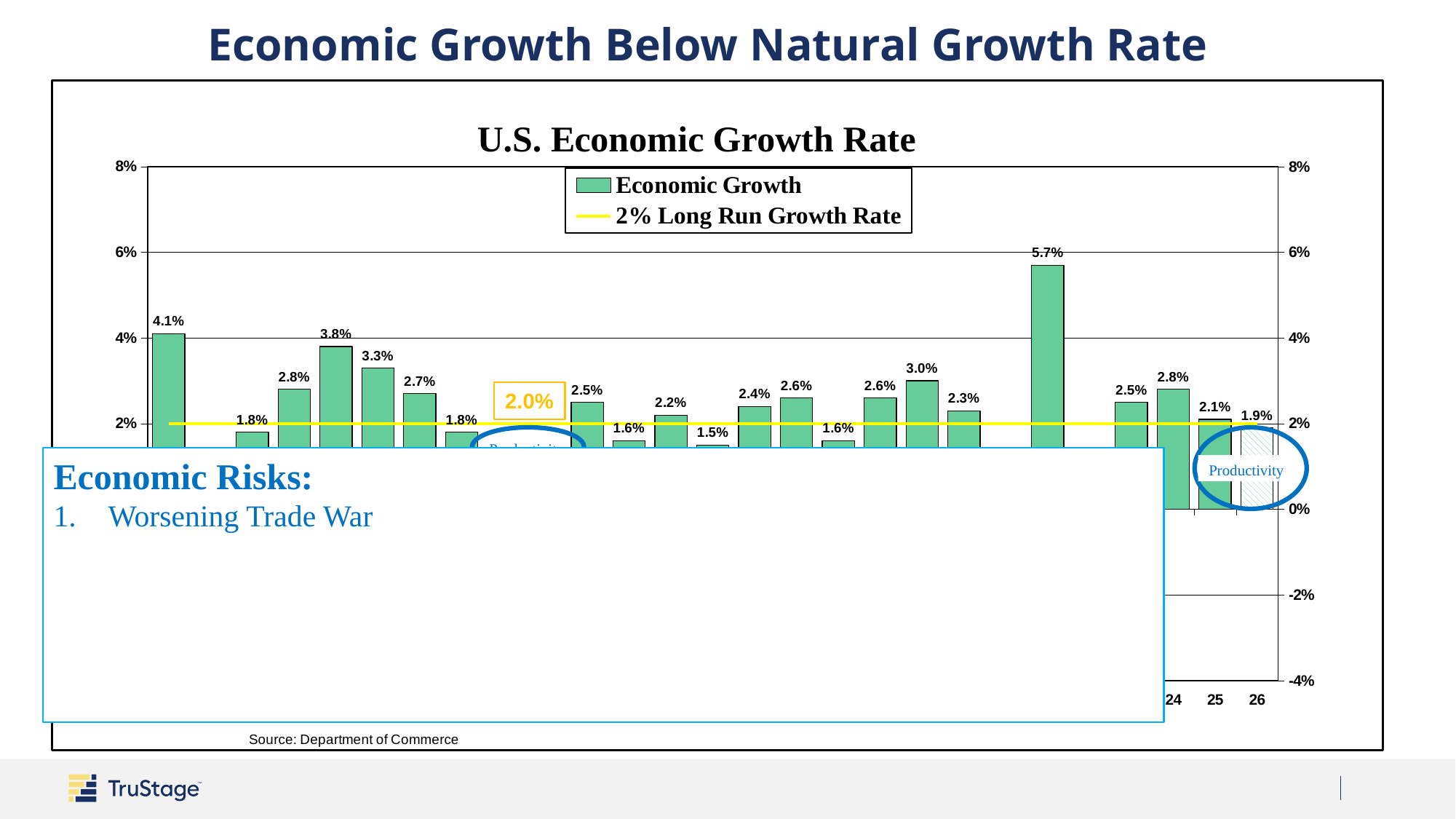
What is the Economic Growth value for 25? 2.1% How many series does the chart legend list? 2 What is the title of the chart? U.S. Economic Growth Rate Is the Economic Growth value for 26 greater or less than 2%? less What kind of chart is used to show Economic Growth? Bar chart What is the difference between the Economic Growth values for 24 and 25? 0.7% Which has the larger Economic Growth value, 25 or 26? 25 What is the Economic Growth value for 24? 2.8% What is the Economic Growth value for 26? 1.9% What value does the yellow Long Run Growth Rate line mark? 2.0% What is the highest Economic Growth value labeled on the chart? 5.7% What is the difference between the Economic Growth values for 25 and 26? 0.2%